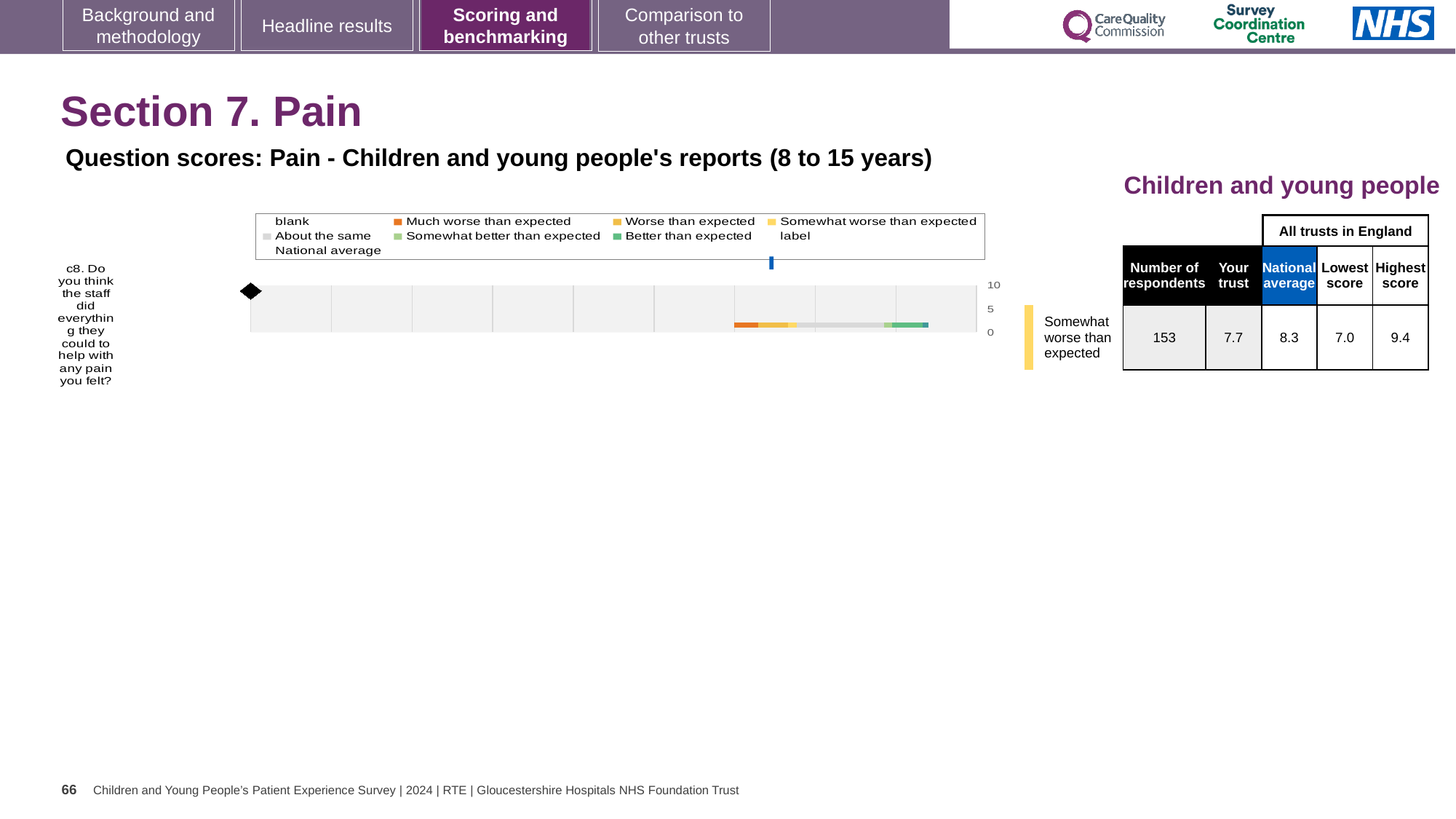
According to the table next to the chart, what is the Highest score among all trusts in England for question c8? 9.4 According to the table next to the chart, what is the score for Your trust for question c8? 7.7 What is the maximum value shown on the chart's axis? 10 Which is larger for question c8: the Your trust score or the National average? National average How many questions (categories) are plotted in the chart? 1 According to the table next to the chart, what is the National average score for question c8? 8.3 What kind of chart is shown on the slide? bar chart What benchmark category is the trust's result for question c8 labelled as? Somewhat worse than expected Which question is plotted in the chart? c8. Do you think the staff did everything they could to help with any pain you felt? According to the table next to the chart, what is the Lowest score among all trusts in England for question c8? 7.0 What is the difference between the National average (8.3) and the Your trust score (7.7) for question c8? 0.6 According to the table next to the chart, how many respondents answered question c8? 153